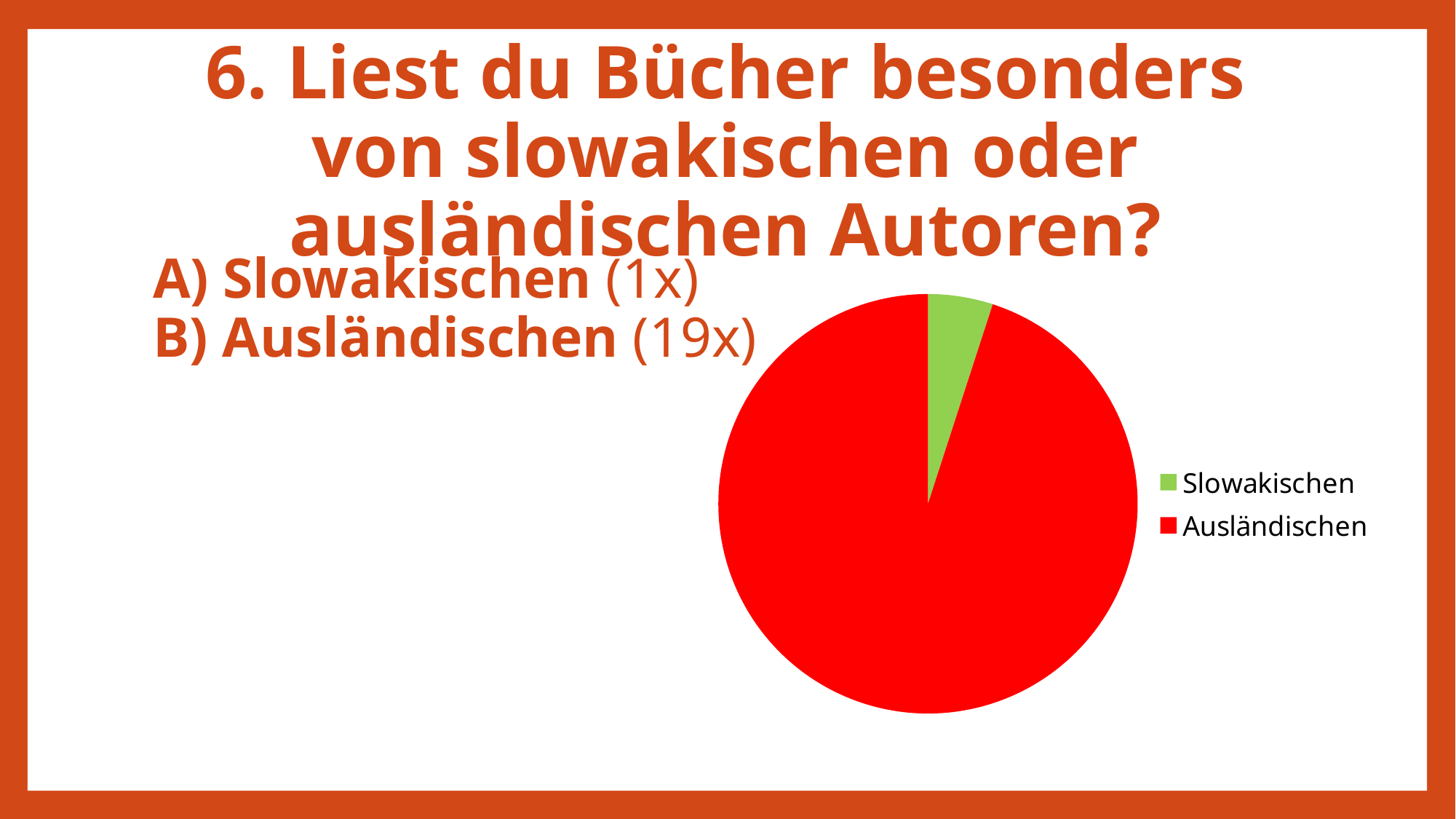
How many responses are shown for Slowakischen? 1x How many responses are shown for Ausländischen? 19x How many entries does the legend of the pie chart list? 2 Which category has the smallest slice in the pie chart? Slowakischen What colour is the Slowakischen slice in the pie chart? green What share of the pie does the Ausländischen slice represent? 95% Which is larger, the slice for Slowakischen or the slice for Ausländischen? Ausländischen How many slices does the pie chart have? 2 What kind of chart is shown on the slide? pie chart What is the difference between the number of responses for Ausländischen and Slowakischen? 18 Which category has the largest slice in the pie chart? Ausländischen What colour is the Ausländischen slice in the pie chart? red